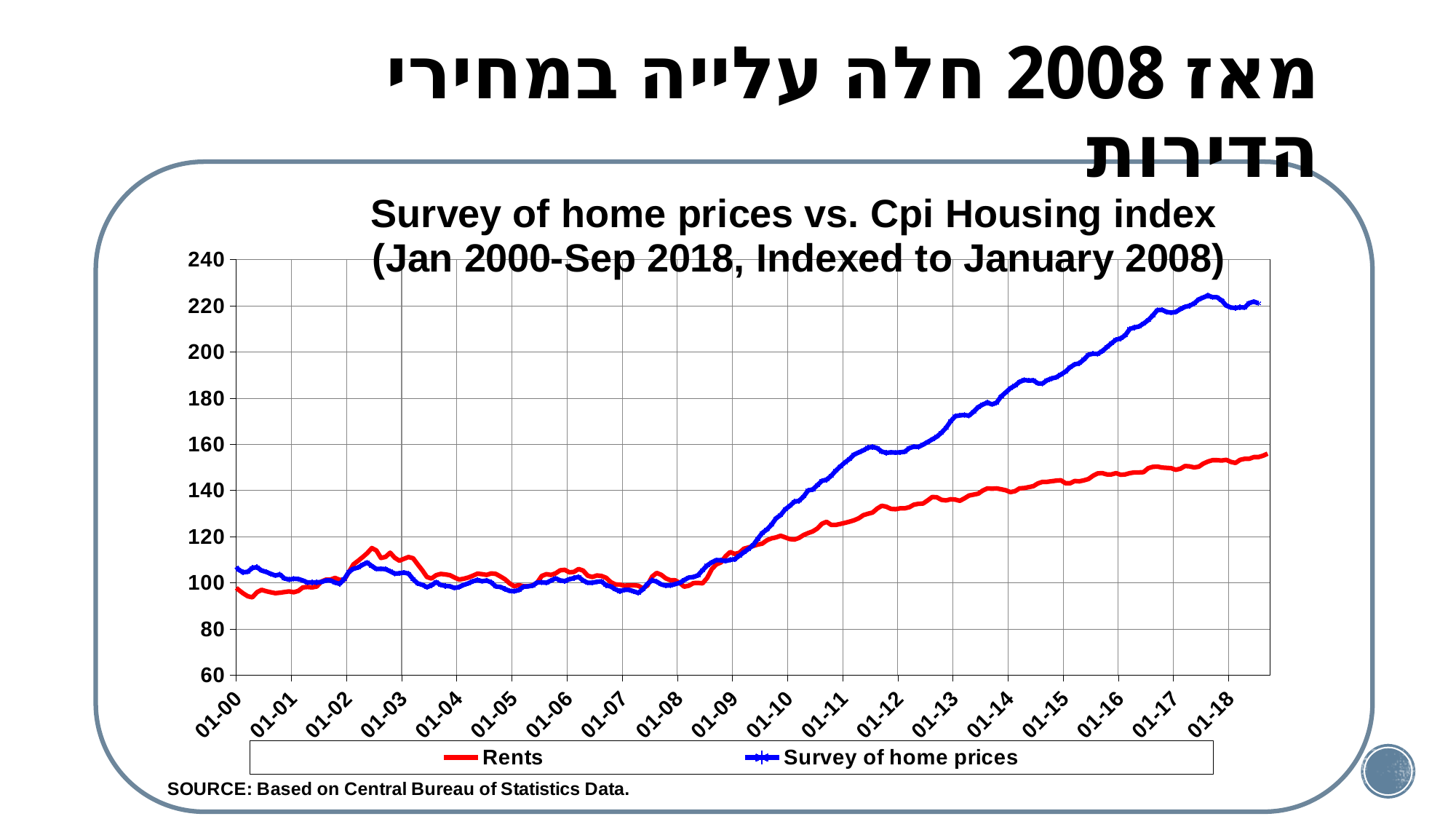
Is the value for Survey of home prices at 01-18 greater or less than 200? greater Is the value for Rents at 01-18 greater or less than 160? less What is the title of the chart? Survey of home prices vs. Cpi Housing index (Jan 2000-Sep 2018, Indexed to January 2008) Is the value for Rents at 01-10 greater or less than 140? less At 01-18, which series has the higher value, Rents or Survey of home prices? Survey of home prices Does the Survey of home prices series rise or fall between 01-08 and 01-18? rise How many series does the legend list? 2 What are the two series named in the legend? Rents and Survey of home prices What kind of chart is shown on the slide? line chart How many date labels are shown on the x axis? 19 Which series reaches the highest value on the chart? Survey of home prices